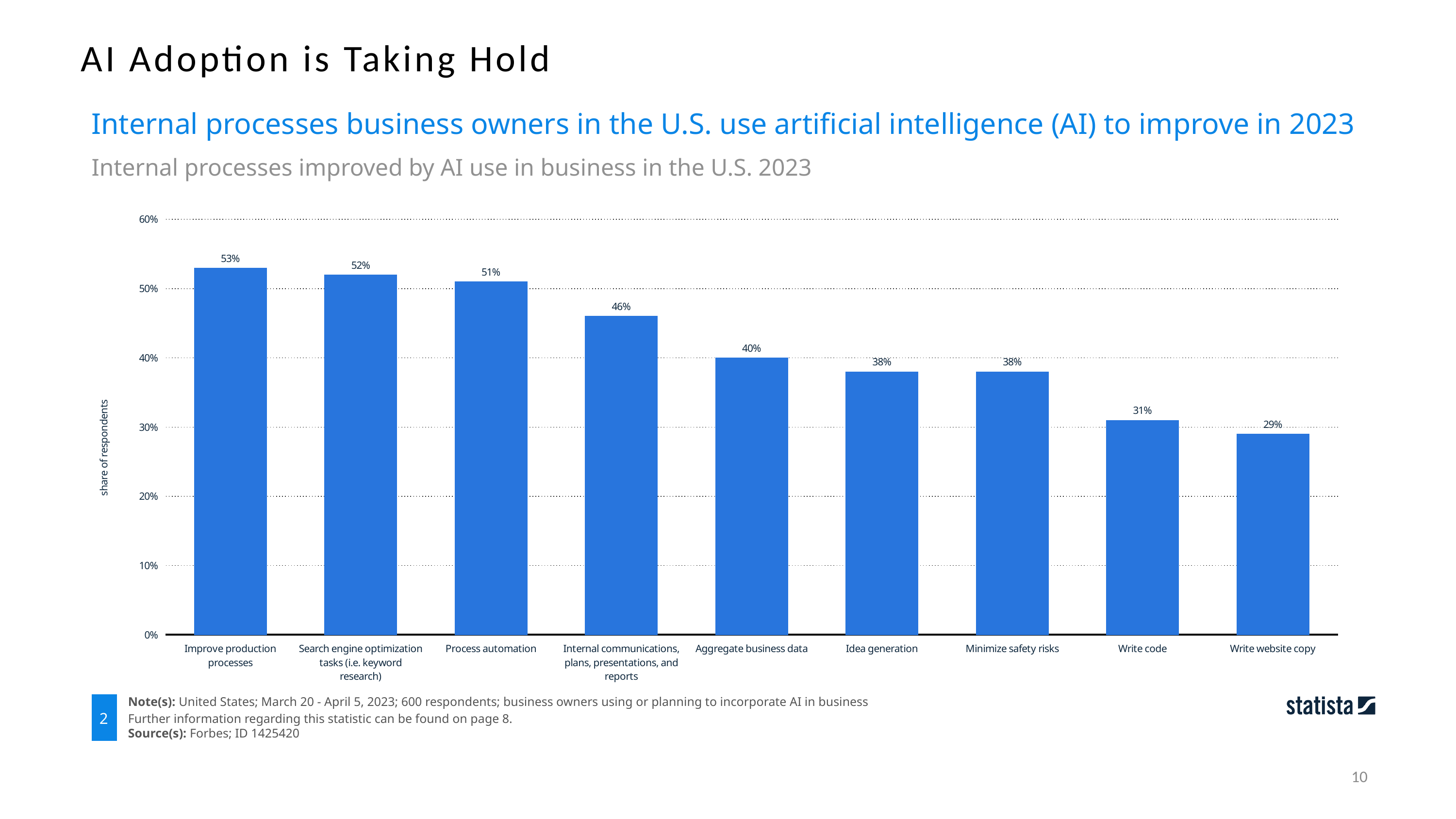
What is the value for Process automation? 51% How many internal processes are shown on the chart? 9 Which is larger, the value for Search engine optimization tasks or the value for Idea generation? Search engine optimization tasks What is the label of the vertical axis? share of respondents What kind of chart is shown on the slide? Bar chart What share of respondents use AI to improve production processes? 53% Which internal process has the highest share of respondents? Improve production processes Is the value for Minimize safety risks greater or less than 40%? less What is the difference between the values for Internal communications, plans, presentations, and reports and Aggregate business data? 6 percentage points Which internal process has the lowest share of respondents? Write website copy What share of respondents use AI for Write code? 31% What is the difference between the values for Improve production processes and Write website copy? 24 percentage points